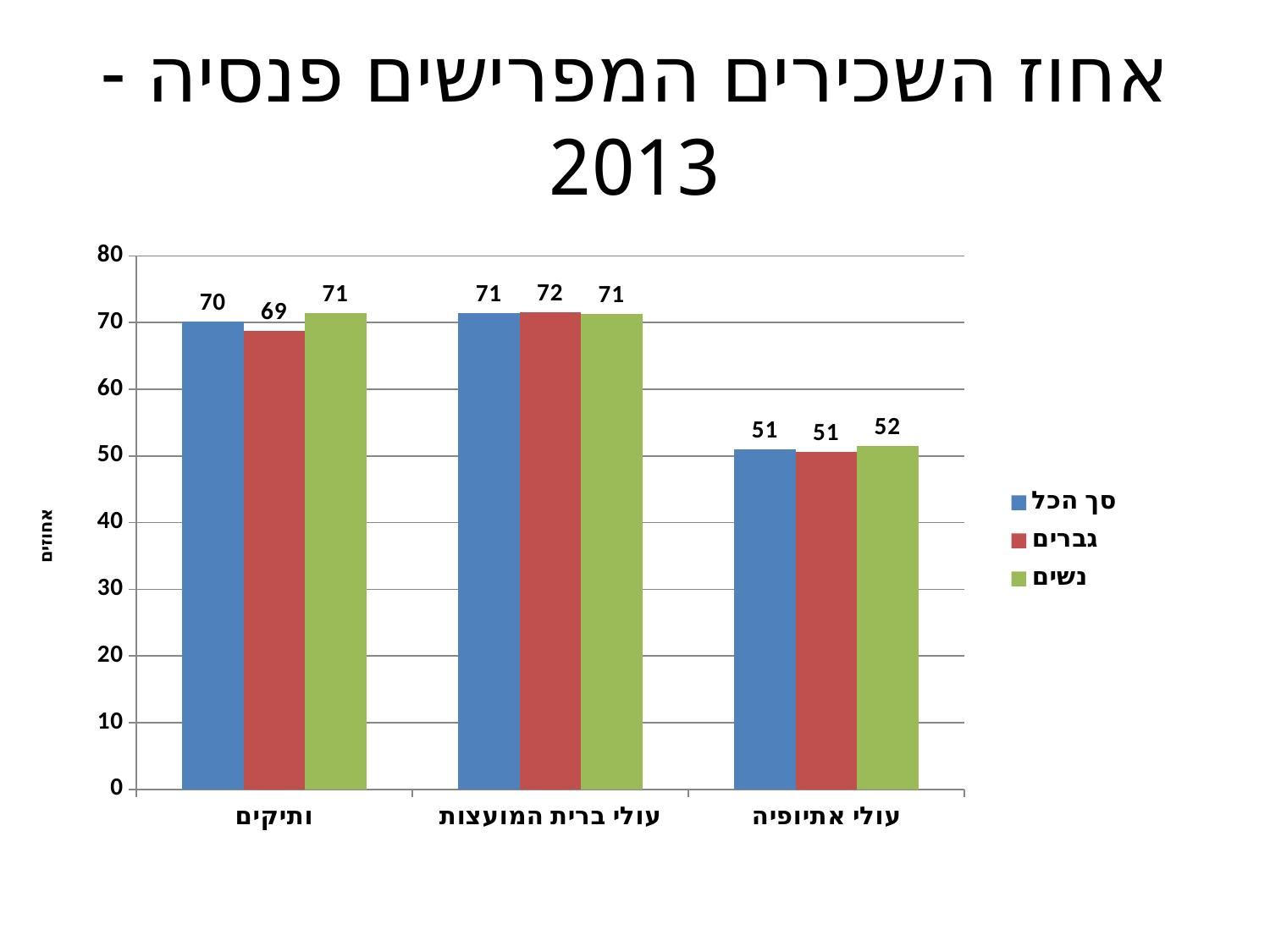
What is the difference between the נשים value for ותיקים and the נשים value for עולי אתיופיה? 19 What is the value for נשים in the עולי אתיופיה category? 52 What is the value for גברים in the עולי ברית המועצות category? 72 How many series does the legend list? 3 What is the value for גברים in the ותיקים category? 69 Which is larger: the סך הכל value for ותיקים or the סך הכל value for עולי אתיופיה? ותיקים What is the title of the slide? אחוז השכירים המפרישים פנסיה - 2013 Which category has the lowest value for סך הכל? עולי אתיופיה What kind of chart is shown on the slide? bar chart How many categories are shown on the x axis? 3 What is the value for סך הכל in the ותיקים category? 70 Which category has the highest value for גברים? עולי ברית המועצות